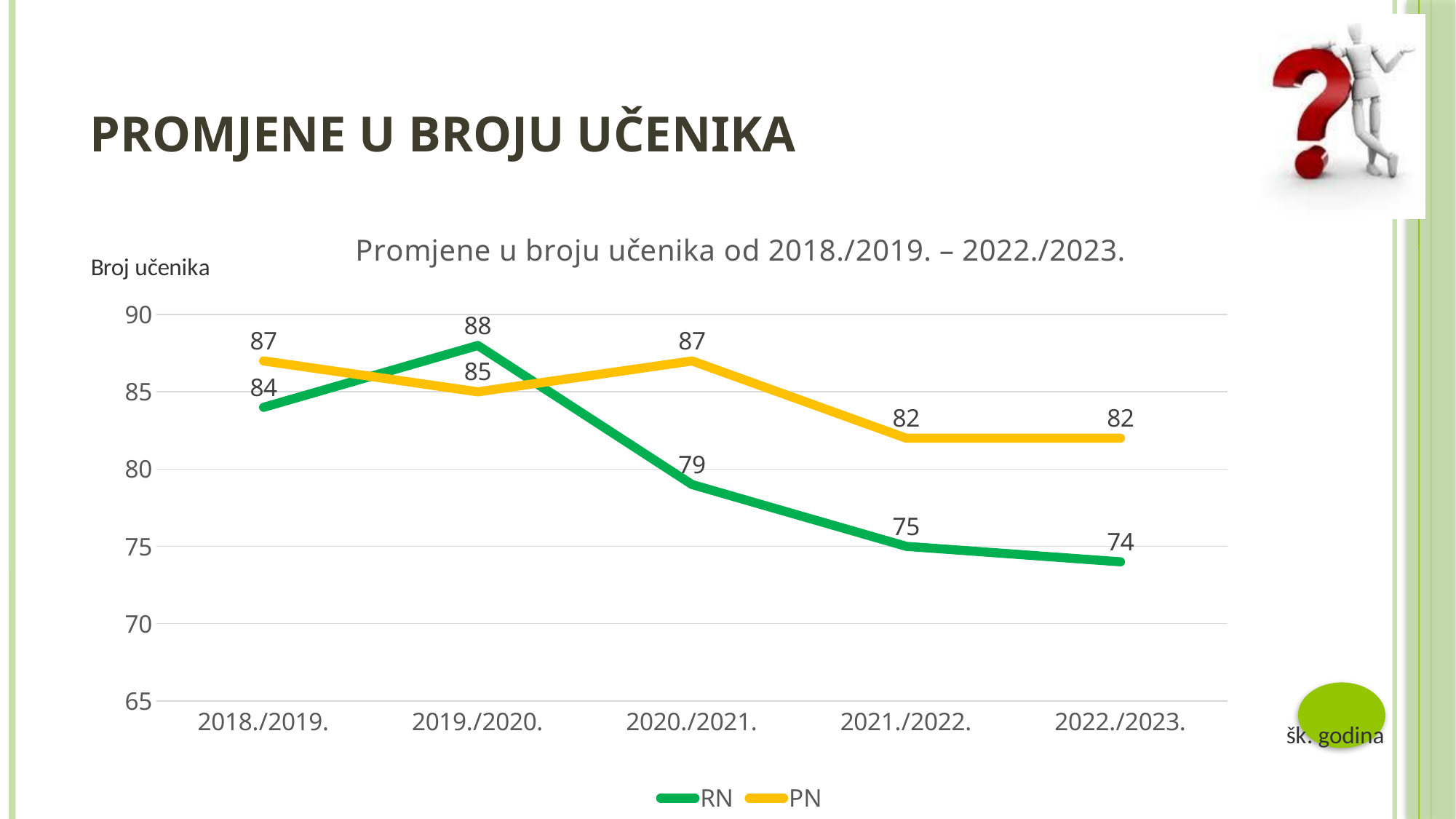
What is the value for RN in 2019./2020.? 88 In which school year is the RN value lowest? 2022./2023. What is the value for PN in 2021./2022.? 82 Is the value for RN in 2020./2021. greater or less than 80? less What is the difference between the PN and RN values in 2022./2023.? 8 In which school year is the RN value highest? 2019./2020. Which series has the larger value in 2019./2020., RN or PN? RN What kind of chart is shown on the slide? line chart Does the RN series rise or fall from 2019./2020. to 2022./2023.? fall What is the value for RN in 2022./2023.? 74 How many series does the legend list? 2 How many school years are shown on the x axis? 5